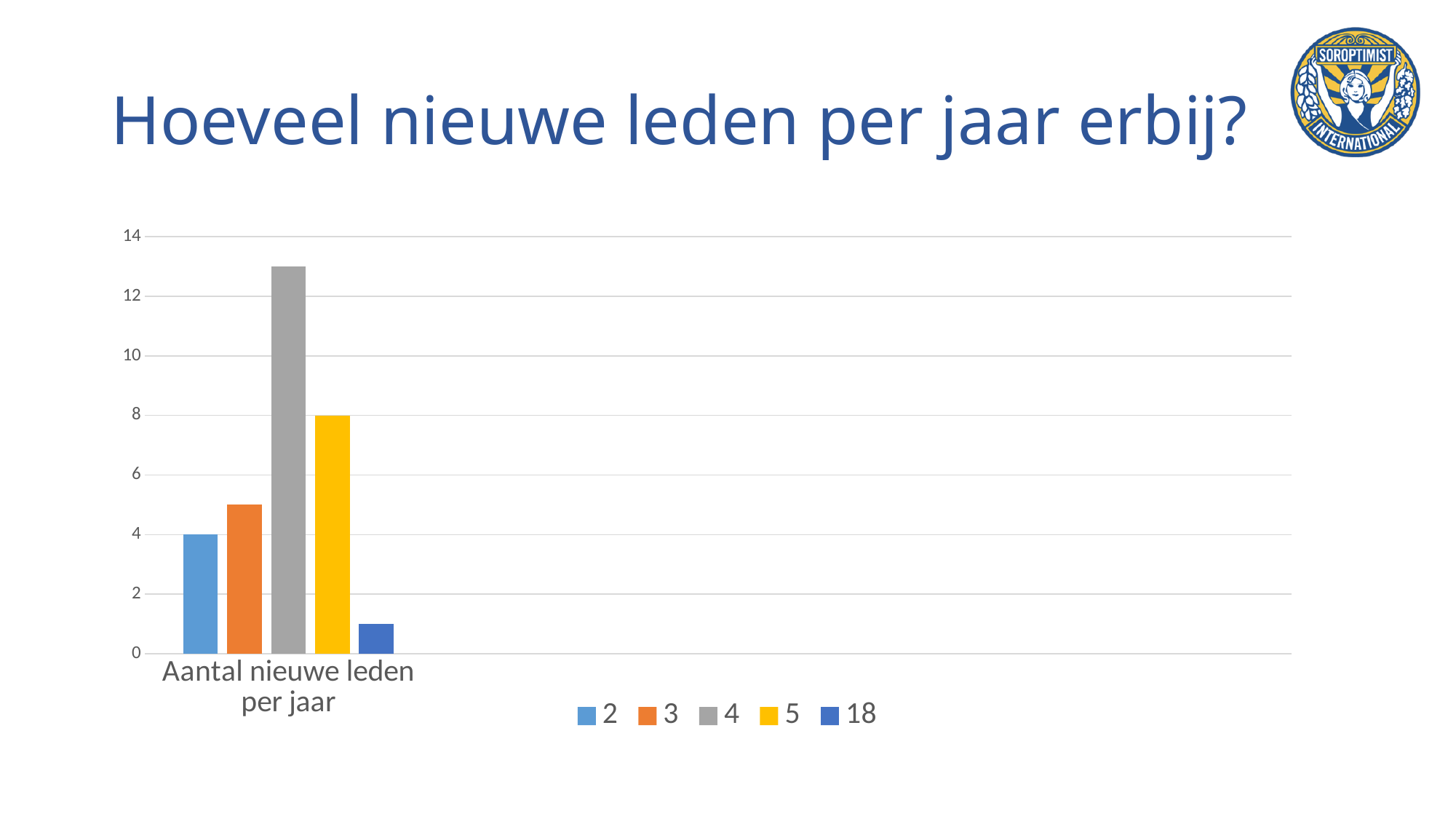
Is the value for series 18 greater or less than 2? less What is the value of the bar for series 5? 8 What kind of chart is shown on the slide? bar chart Which series has the lowest bar? 18 Is the value for series 4 greater or less than 12? greater What is the difference between the bar for series 5 and the bar for series 2? 4 What is the title of the slide above the chart? Hoeveel nieuwe leden per jaar erbij? How many categories are shown on the x axis? 1 What is the value of the bar for series 2? 4 Which bar is taller, series 5 or series 2? 5 How many series does the legend list? 5 Which series has the highest bar? 4